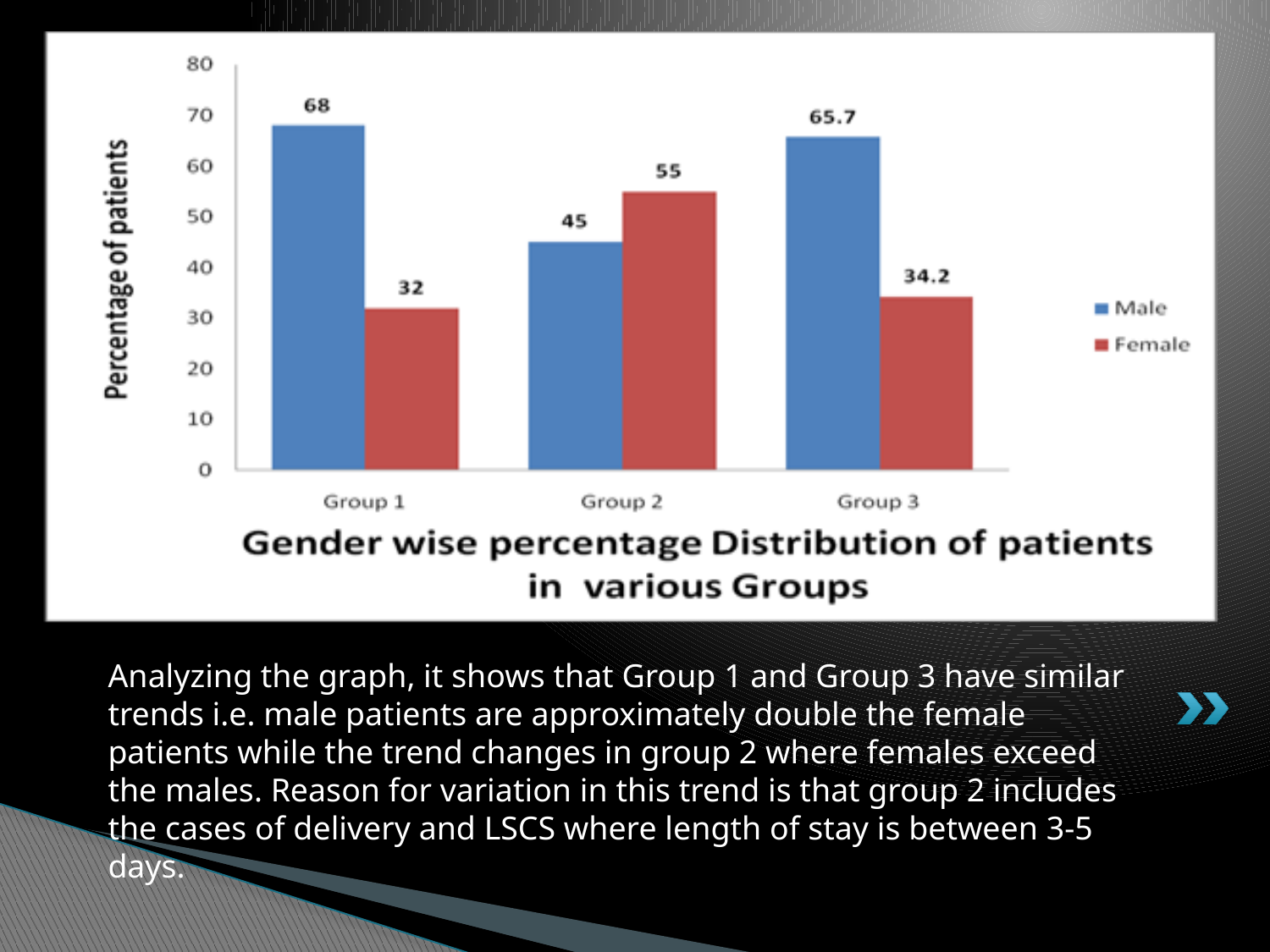
How many series does the legend list? 2 Which group has the lowest Female value? Group 1 What is the Female value for Group 2? 55 Which is larger for Group 2, the Male value or the Female value? Female How many groups are shown on the x axis? 3 What is the title of the chart? Gender wise percentage Distribution of patients in various Groups What is the difference between the Male and Female values for Group 1? 36 Which group has the highest Male value? Group 1 What is the difference between the Female and Male values for Group 2? 10 What is the Male value for Group 1? 68 What kind of chart is shown on the slide? Bar chart What is the Female value for Group 3? 34.2